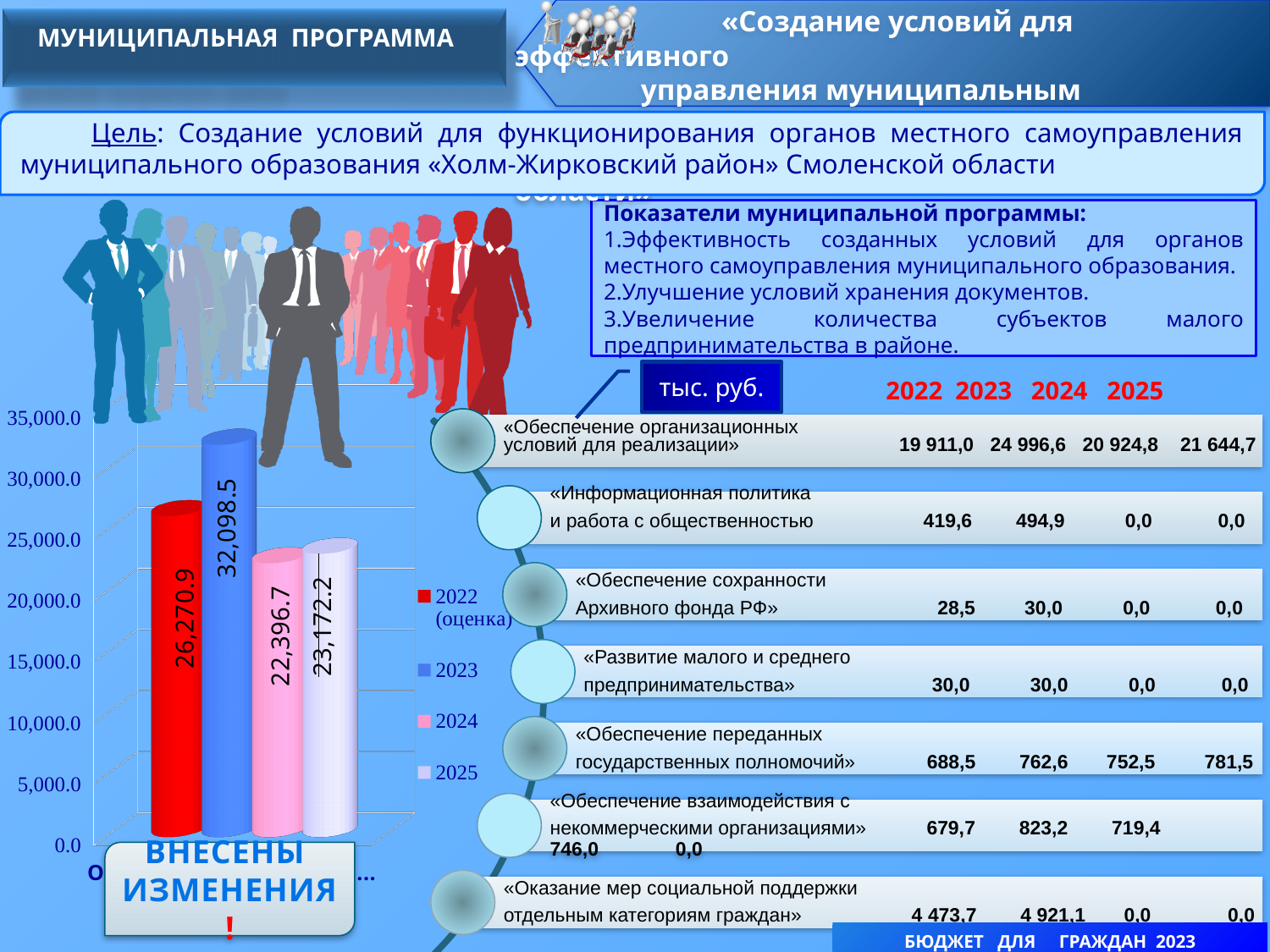
What is the value shown for 2024 in the bar chart? 22,396.7 What is the difference between the 2025 value and the 2024 value in the bar chart? 775.5 What is the value shown for 2025 in the bar chart? 23,172.2 What is the difference between the 2023 value and the 2022 (оценка) value in the bar chart? 5,827.6 What kind of chart is shown on the left of the slide? bar chart Which year has the highest value in the bar chart? 2023 Is the value for 2023 in the bar chart greater or less than 30,000.0? greater How many series does the legend of the bar chart list? 4 Which is larger in the bar chart, the value for 2022 (оценка) or the value for 2024? 2022 (оценка) What is the value shown for 2023 in the bar chart? 32,098.5 Which year has the lowest value in the bar chart? 2024 What is the value shown for 2022 (оценка) in the bar chart? 26,270.9